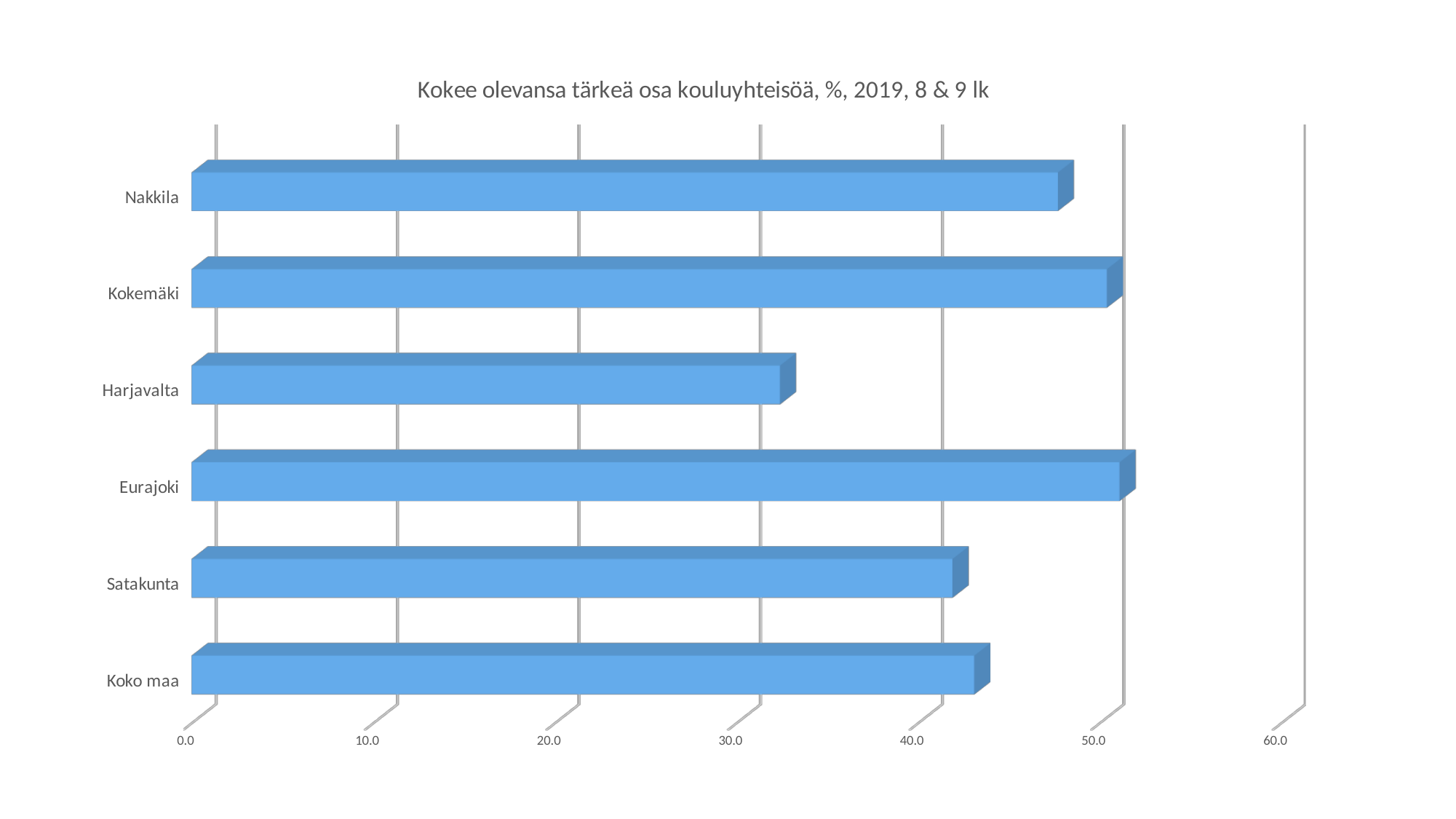
Which has a larger value, Kokemäki or Nakkila? Kokemäki Which has a larger value, Nakkila or Harjavalta? Nakkila Is the value for Harjavalta greater or less than 40? less What kind of chart is shown on the slide? bar chart Is the value for Koko maa greater or less than 50? less How many categories are plotted in the chart? 6 What is the title of the chart? Kokee olevansa tärkeä osa kouluyhteisöä, %, 2019, 8 & 9 lk Is the value for Harjavalta greater or less than 30? greater Which category has the lowest value in the chart? Harjavalta Which has a larger value, Eurajoki or Satakunta? Eurajoki